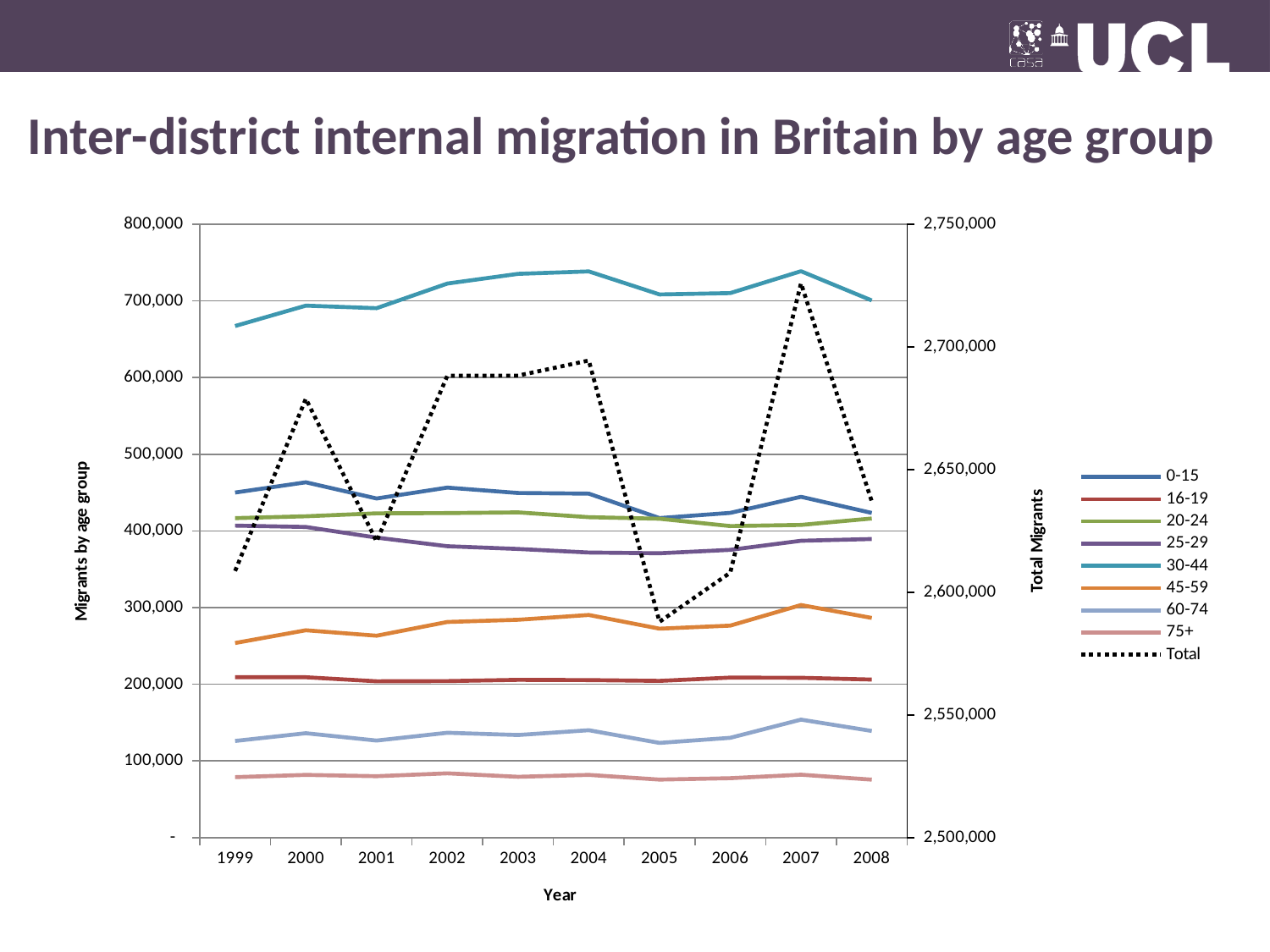
Is the Total value in 2005 greater or less than 2,600,000? less How many series does the legend list? 9 Which age group has the highest number of migrants across all years? 30-44 In which year does the Total series reach its lowest value? 2005 Is the value for the 30-44 age group in 2004 greater or less than 700,000? greater Does the 30-44 series rise or fall between 1999 and 2004? rise How many years are plotted along the x axis? 10 In 2000, which is larger: the value for 0-15 or the value for 20-24? 0-15 In which year does the Total series reach its highest value? 2007 Is the value for the 30-44 age group in 1999 greater or less than 700,000? less What kind of chart is shown on the slide? line chart Which age group has the lowest number of migrants across all years? 75+